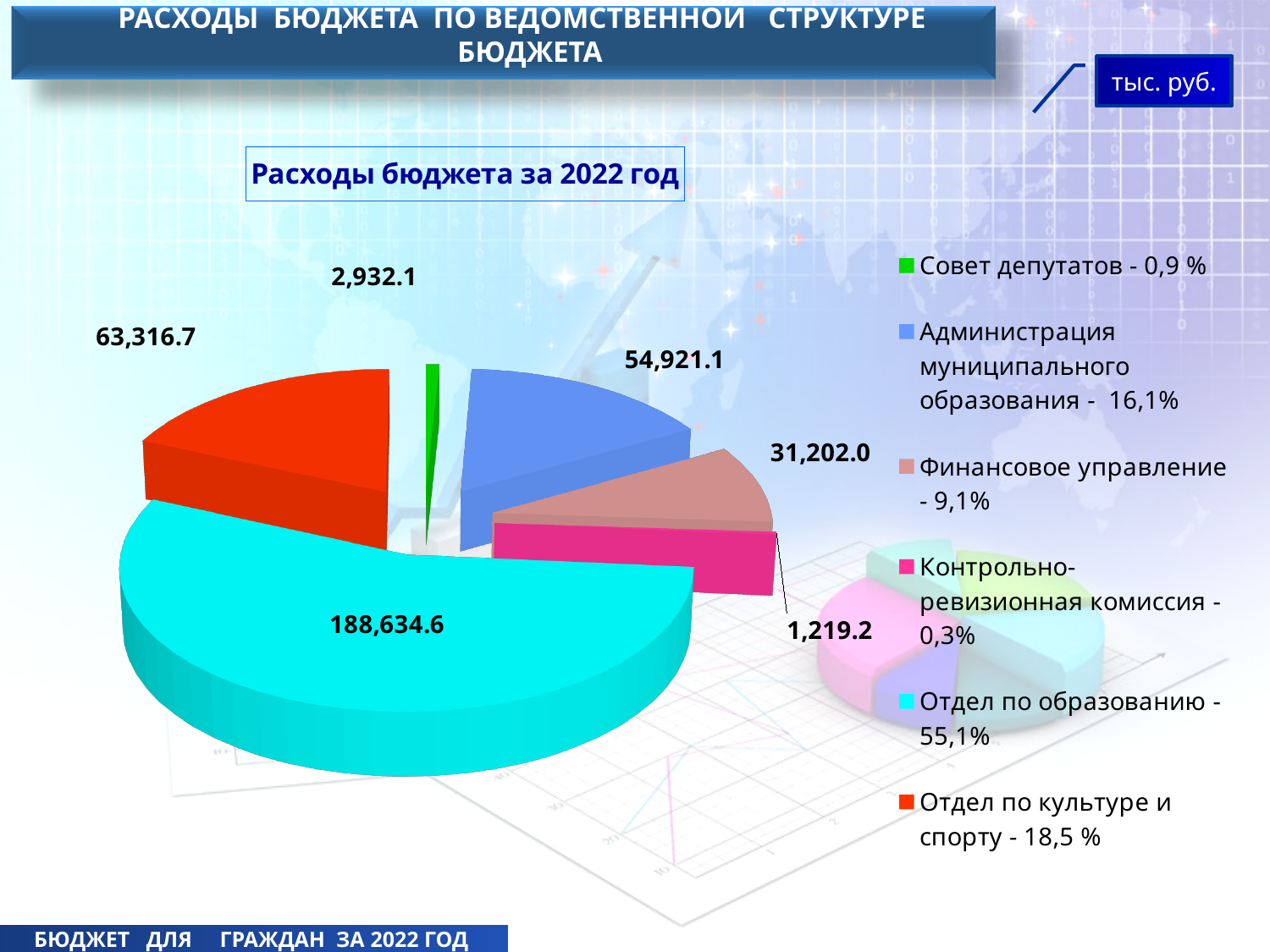
What is the value for Финансовое управление? 31,202.0 Which category has the largest slice of the pie? Отдел по образованию What share of the pie does Отдел по культуре и спорту represent? 18,5 % Which is larger, the value for Совет депутатов or the value for Финансовое управление? Финансовое управление What kind of chart is shown on the slide? pie chart What is the difference between the values for Отдел по культуре и спорту and Администрация муниципального образования? 8,395.6 What is the value for Контрольно-ревизионная комиссия? 1,219.2 Which category has the smallest slice of the pie? Контрольно-ревизионная комиссия What is the value for Отдел по образованию? 188,634.6 What is the title of the chart? Расходы бюджета за 2022 год How many slices does the pie chart have? 6 What is the value for Администрация муниципального образования? 54,921.1